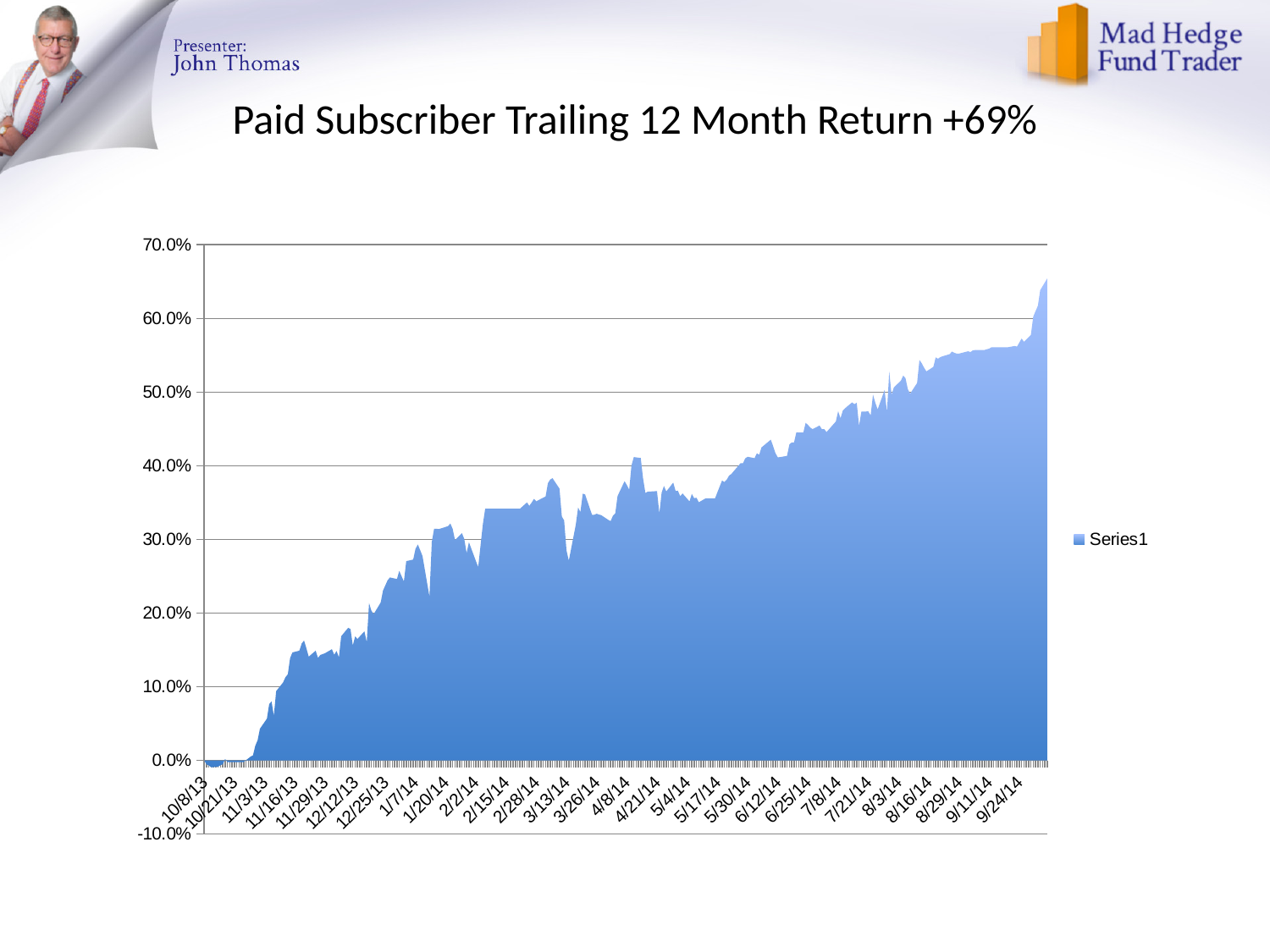
What kind of chart is shown on the slide? area chart What is the title of the chart? Paid Subscriber Trailing 12 Month Return +69% Is the value at 9/24/14 greater or less than 50.0%? greater Is the value at 1/7/14 greater or less than 20.0%? greater Is the value at 5/4/14 greater or less than 30.0%? greater Do the values generally rise or fall from 10/8/13 to 9/24/14? rise What is the highest value labelled on the vertical axis? 70.0% How many series does the legend list? 1 What is the name of the series shown in the legend? Series1 Which is larger, the value at 9/24/14 or the value at 10/8/13? 9/24/14